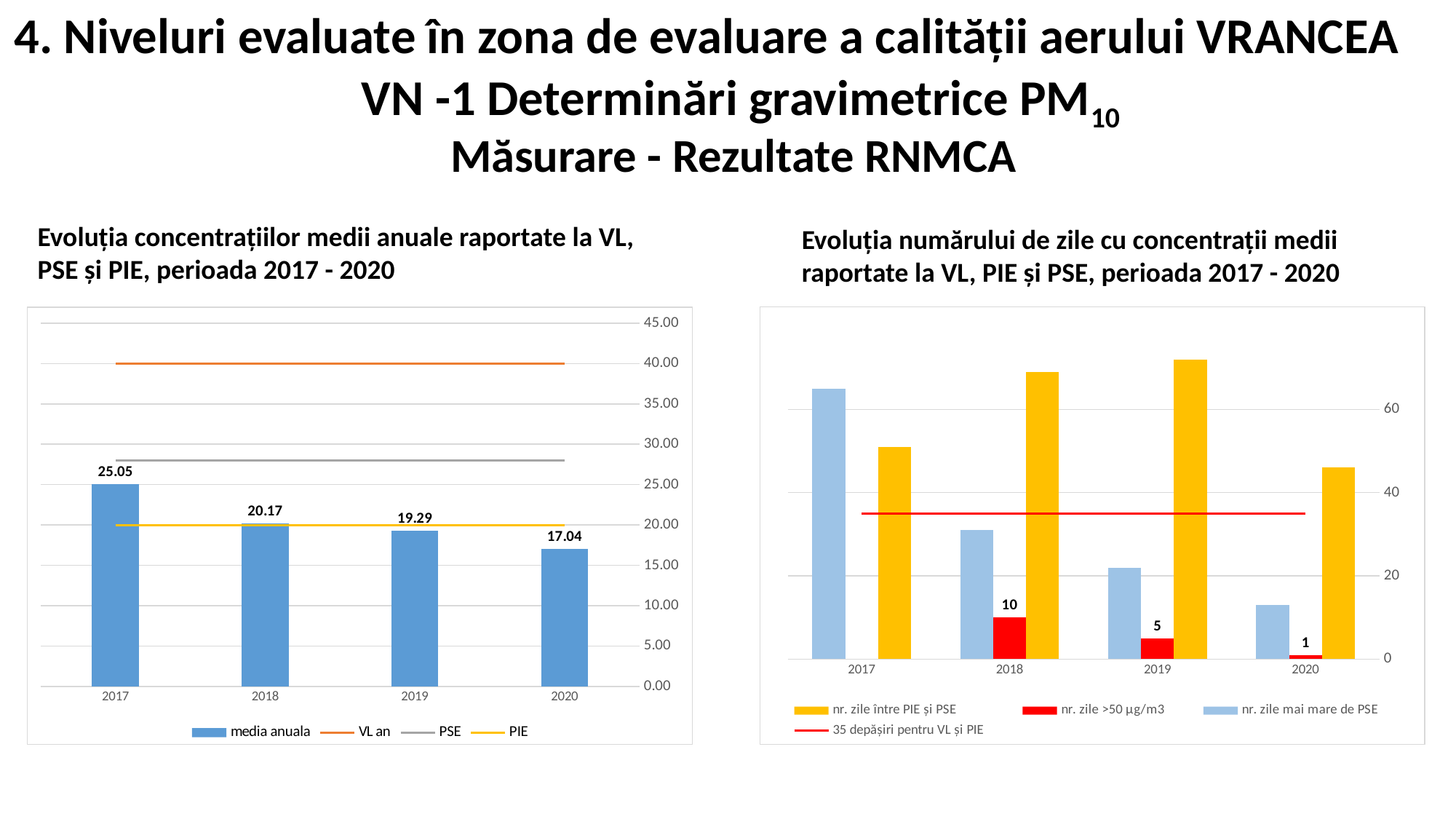
In the left chart (Evoluția concentrațiilor medii anuale), what is the difference between the media anuala for 2018 and 2019? 0.88 In the right chart (Evoluția numărului de zile), what is the value of nr. zile >50 µg/m3 for 2020? 1 In the left chart (Evoluția concentrațiilor medii anuale), what is the value of media anuala for 2020? 17.04 In the left chart (Evoluția concentrațiilor medii anuale), how many entries does the legend list? 4 In the left chart (Evoluția concentrațiilor medii anuale), is the VL an line greater or less than 35.00? greater In the left chart (Evoluția concentrațiilor medii anuale), which year has the lowest media anuala? 2020 In the right chart (Evoluția numărului de zile), what is the value of nr. zile >50 µg/m3 for 2018? 10 In the left chart (Evoluția concentrațiilor medii anuale), which year has the highest media anuala? 2017 In the right chart (Evoluția numărului de zile), which year has the highest nr. zile între PIE și PSE? 2019 In the left chart (Evoluția concentrațiilor medii anuale), do the media anuala values rise or fall from 2017 to 2020? fall In the right chart (Evoluția numărului de zile), is the value of nr. zile mai mare de PSE for 2017 greater or less than 60? greater In the left chart (Evoluția concentrațiilor medii anuale), what is the value of media anuala for 2017? 25.05